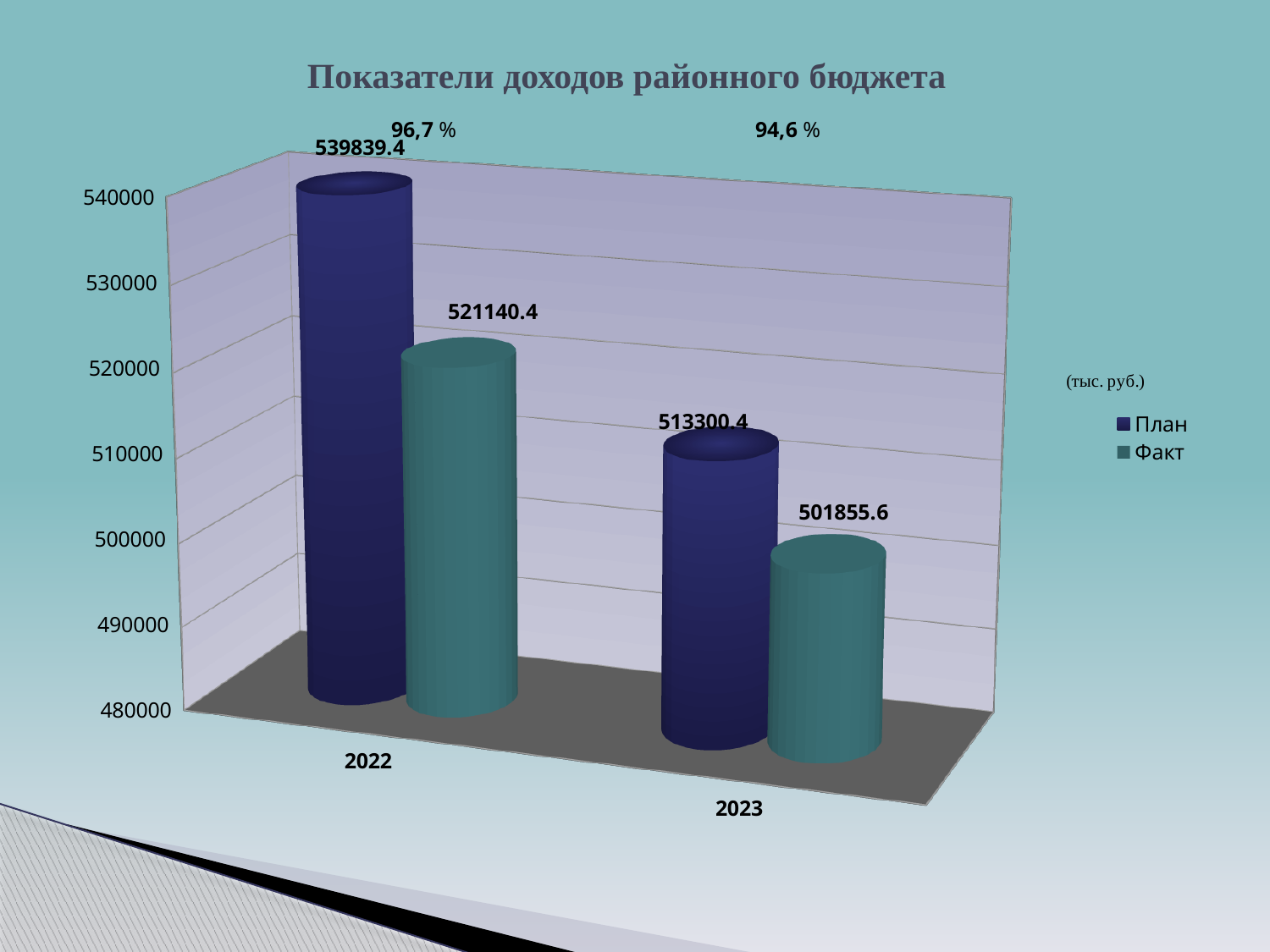
Which year has the highest План value? 2022 What is the План value for 2022? 539839.4 Which is larger for 2023, the План value or the Факт value? План What is the Факт value for 2023? 501855.6 What is the title of the chart? Показатели доходов районного бюджета What is the difference between the План and Факт values for 2023? 11444.8 What is the difference between the План and Факт values for 2022? 18699.0 What is the План value for 2023? 513300.4 What kind of chart is shown on the slide? Bar chart What is the Факт value for 2022? 521140.4 Which year has the lowest Факт value? 2023 How many series does the legend list? 2